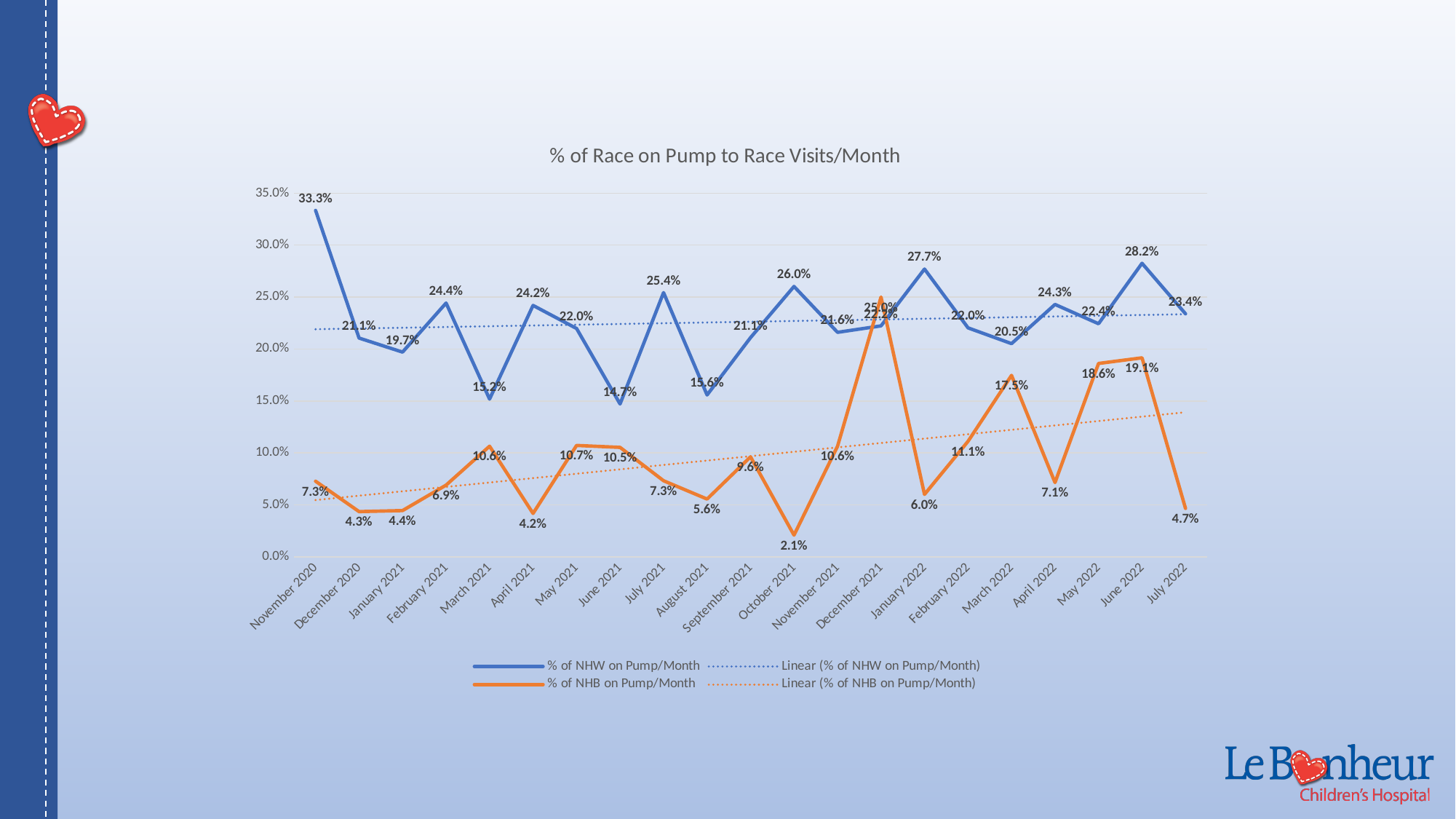
In which month is the % of NHW on Pump/Month lowest? June 2021 What is the % of NHW on Pump/Month for November 2020? 33.3% What is the % of NHB on Pump/Month for May 2022? 18.6% What is the title of the chart? % of Race on Pump to Race Visits/Month What kind of chart is shown on the slide? Line chart Does the dotted linear trend line for % of NHB on Pump/Month rise or fall from left to right? Rise How many entries does the legend list? 4 How many months are shown on the x axis? 21 In which month is the % of NHB on Pump/Month highest? December 2021 What is the difference between the % of NHW on Pump/Month and the % of NHB on Pump/Month in June 2022? 9.1 percentage points In March 2021, which is larger: the % of NHW on Pump/Month or the % of NHB on Pump/Month? % of NHW on Pump/Month What is the % of NHB on Pump/Month for October 2021? 2.1%